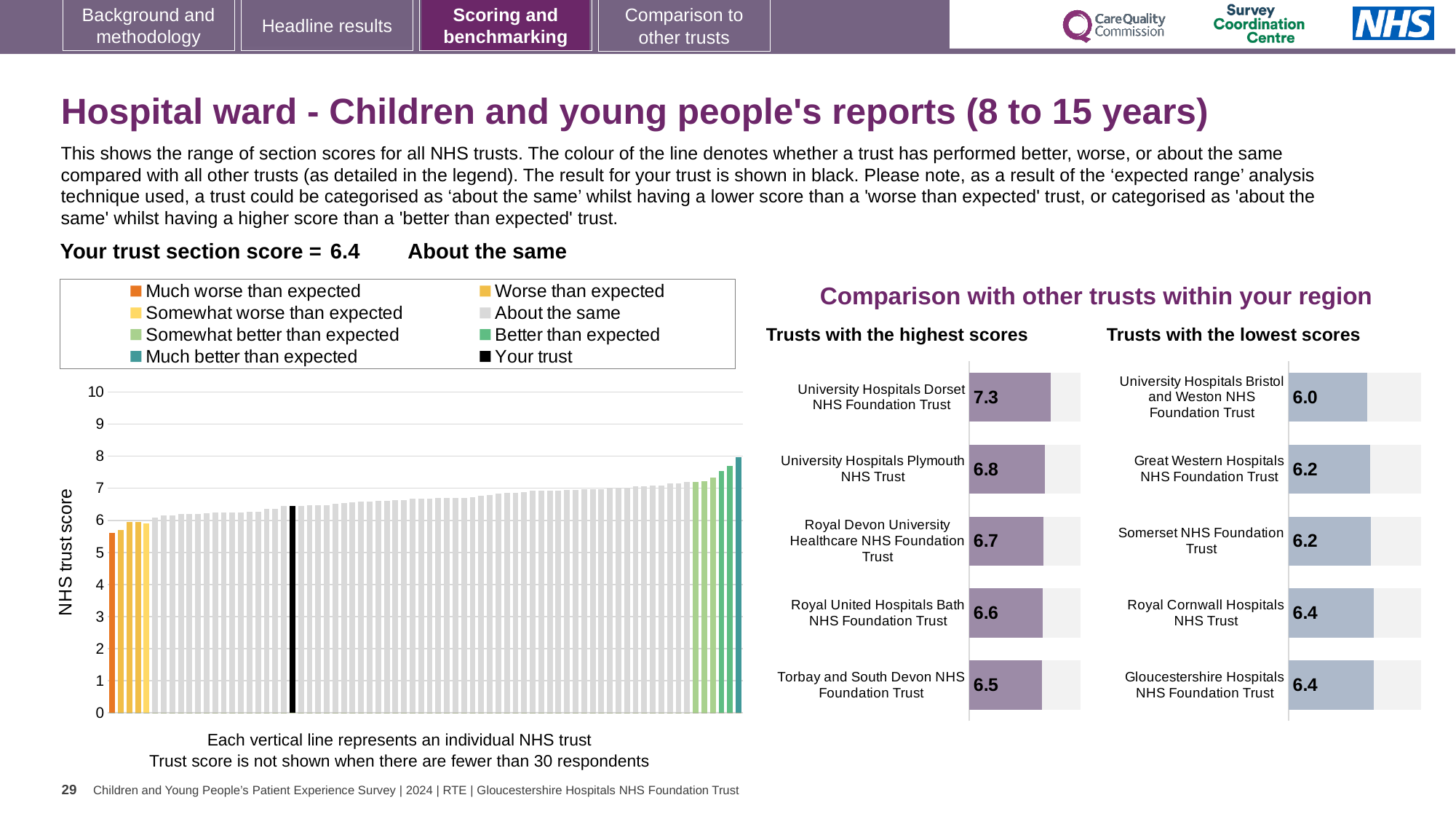
In the chart on the left showing all NHS trusts, is the value of the black 'Your trust' bar greater or less than 6? greater In the chart on the left showing all NHS trusts, what kind of chart is it? bar chart In the 'Trusts with the highest scores' chart, what is the score for Royal Devon University Healthcare NHS Foundation Trust? 6.7 In the chart on the left showing all NHS trusts, do the bar values rise or fall from left to right? rise In the chart on the left showing all NHS trusts, what is the label on the vertical axis? NHS trust score In the 'Trusts with the highest scores' chart, which trust has the highest score? University Hospitals Dorset NHS Foundation Trust In the chart on the left showing all NHS trusts, how many entries does the legend list? 8 In the 'Trusts with the lowest scores' chart, how many trusts are shown? 5 In the 'Trusts with the lowest scores' chart, which trust has the lowest score? University Hospitals Bristol and Weston NHS Foundation Trust In the 'Trusts with the highest scores' chart, what is the difference between the scores of University Hospitals Dorset NHS Foundation Trust and Torbay and South Devon NHS Foundation Trust? 0.8 In the 'Trusts with the highest scores' chart, which has the larger score: University Hospitals Plymouth NHS Trust or Royal United Hospitals Bath NHS Foundation Trust? University Hospitals Plymouth NHS Trust In the 'Trusts with the lowest scores' chart, what is the score for Gloucestershire Hospitals NHS Foundation Trust? 6.4